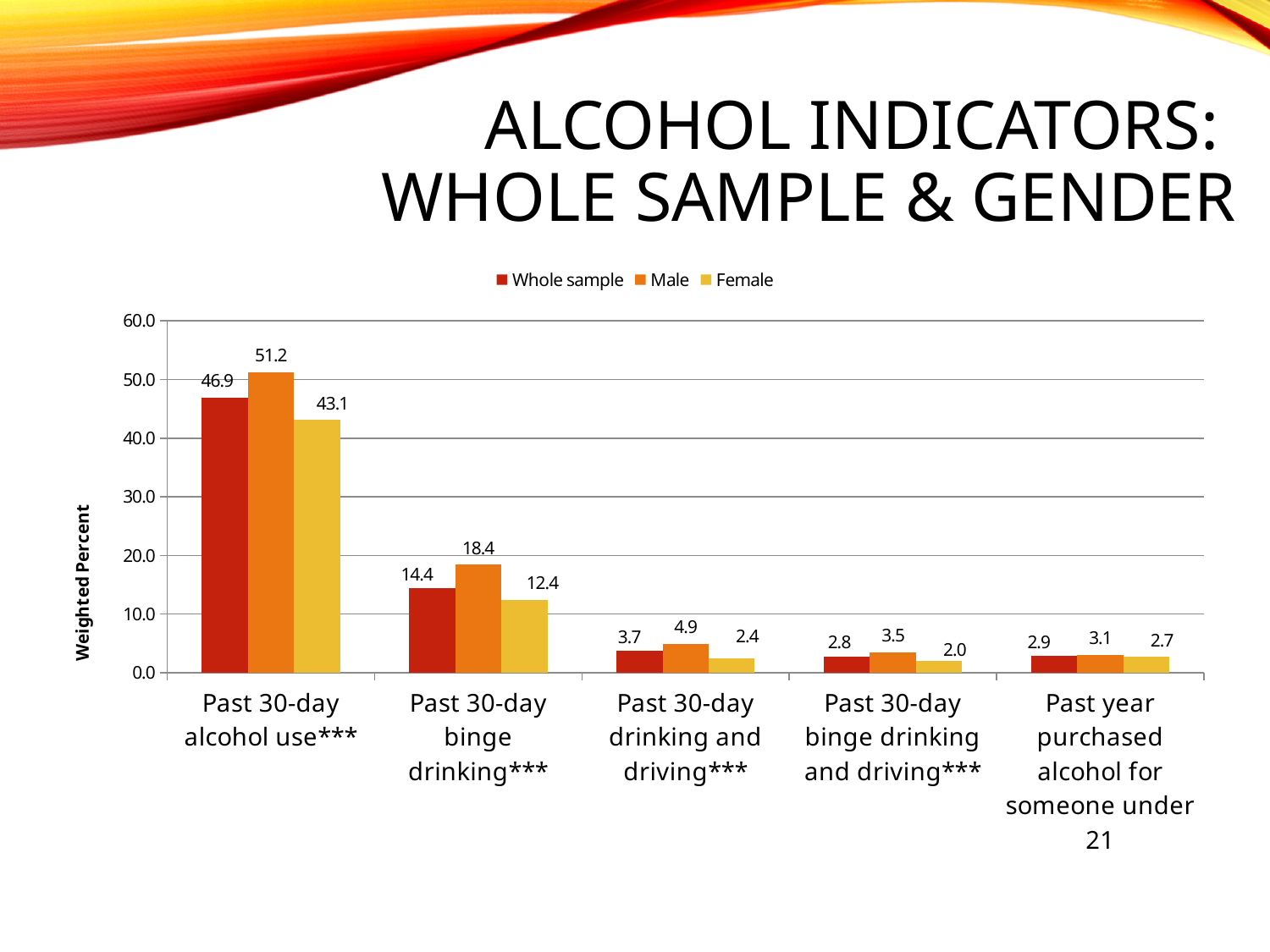
What is the difference between the Male and Female values for Past 30-day alcohol use? 8.1 What is the Female value for Past 30-day binge drinking? 12.4 What is the Whole sample value for Past year purchased alcohol for someone under 21? 2.9 What is the label of the y axis? Weighted Percent Which is larger for Past 30-day drinking and driving: the Male value or the Female value? Male Which category has the highest Whole sample value? Past 30-day alcohol use What kind of chart is shown on the slide? Bar chart How many series does the legend list? 3 Which category has the lowest Female value? Past 30-day binge drinking and driving What is the Male value for Past 30-day alcohol use? 51.2 Is the Female value for Past 30-day alcohol use greater or less than 40.0? greater How many categories are shown on the x axis? 5